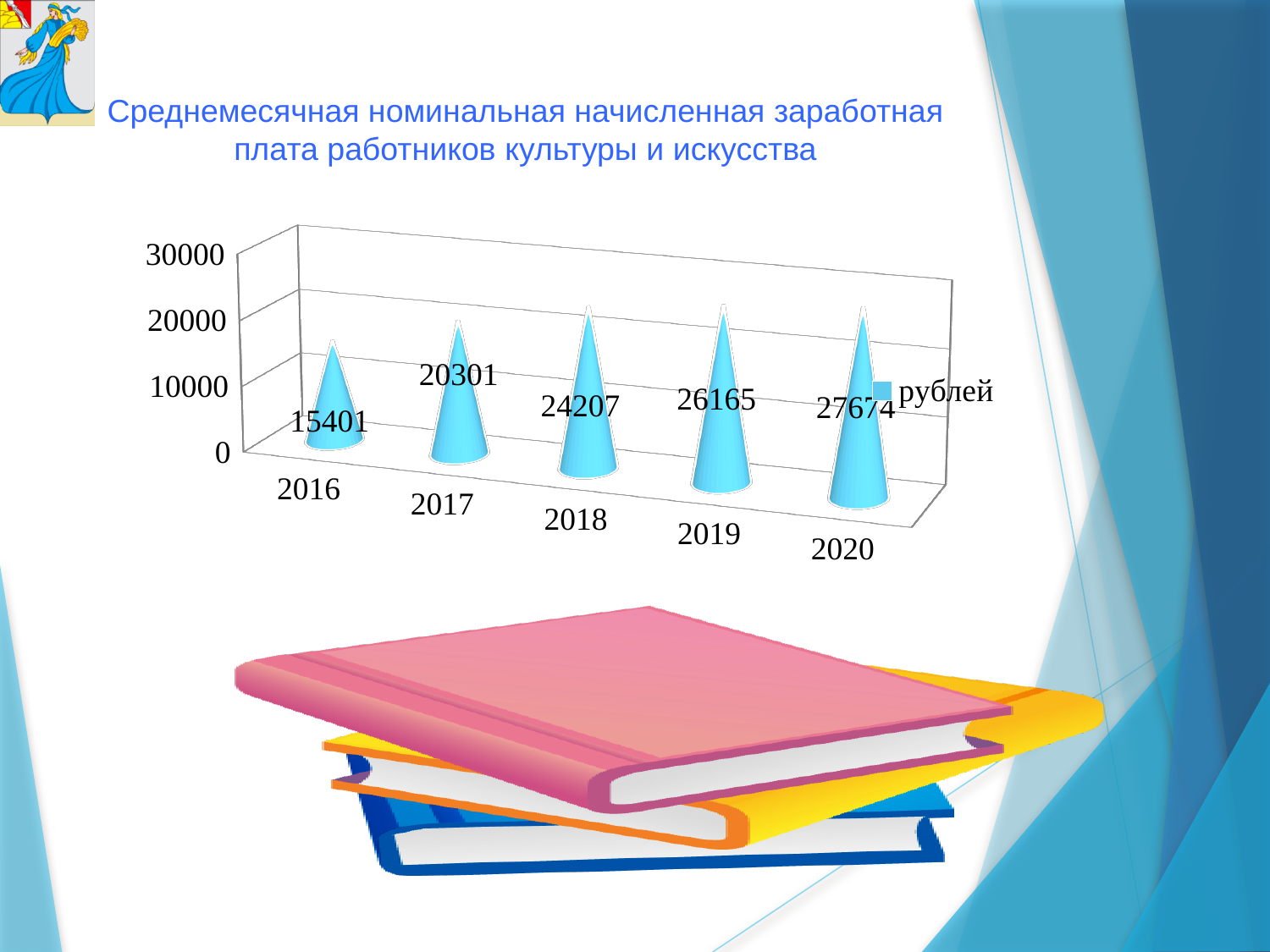
What is the legend entry shown on the chart? рублей Which year has the lowest value? 2016 What is the difference between the values for 2019 and 2018? 1958 Which year has the highest value? 2020 Is the value for 2017 greater or less than 10000? greater What is the value for 2016? 15401 Which is larger, the value for 2017 or the value for 2019? 2019 Do the values rise or fall from 2016 to 2020? rise What is the value for 2018? 24207 How many years are shown on the x axis? 5 What is the value for 2020? 27674 What is the difference between the values for 2020 and 2016? 12273